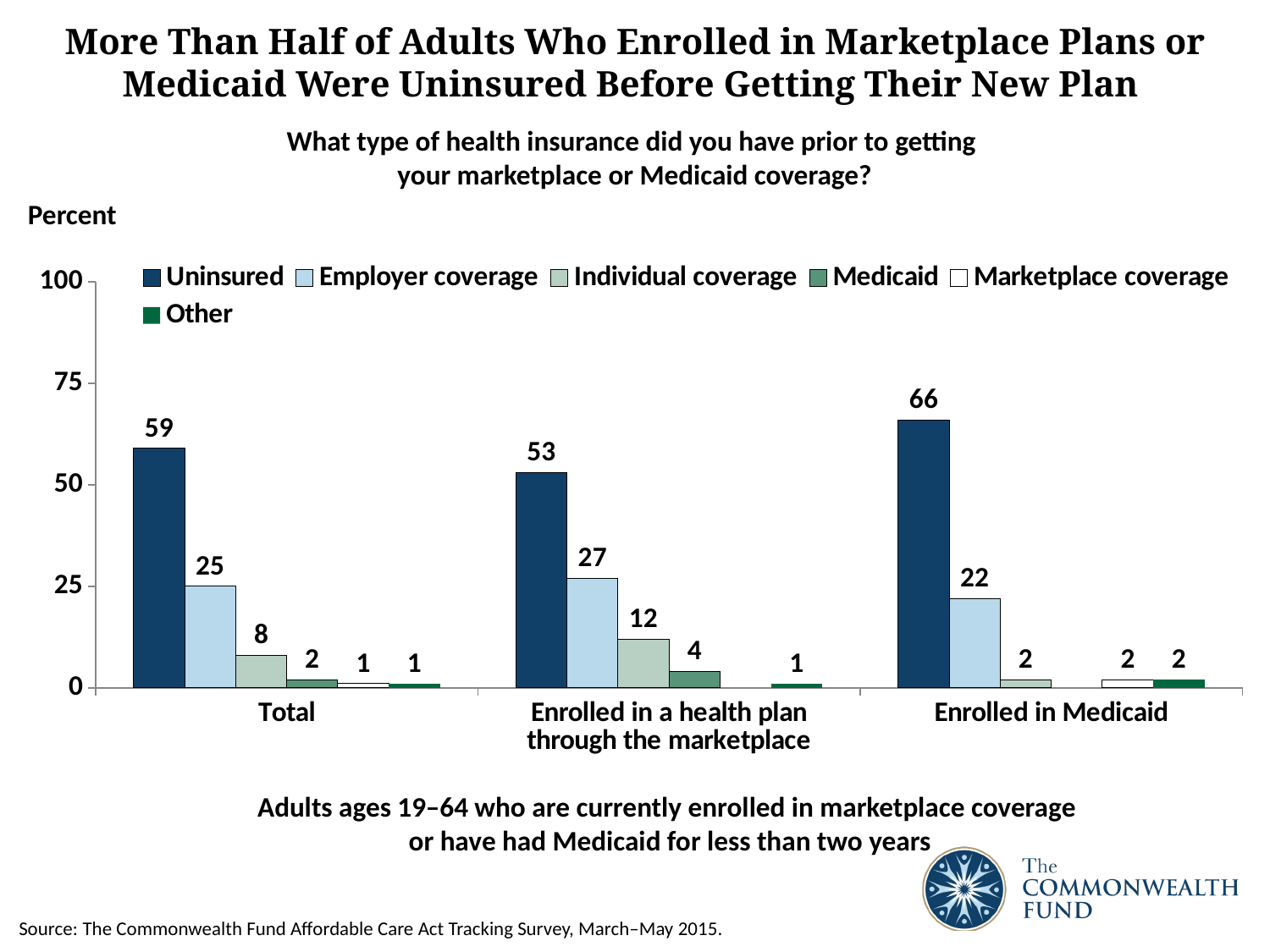
What is the difference between the Uninsured values for Enrolled in Medicaid and Enrolled in a health plan through the marketplace? 13 What is the value for Individual coverage in the Total group? 8 What kind of chart is shown on the slide? Bar chart How many series does the legend list? 6 Which group has the lowest Employer coverage value? Enrolled in Medicaid What is the value for Employer coverage among adults enrolled in a health plan through the marketplace? 27 Which is larger: Individual coverage for Enrolled in a health plan through the marketplace or Individual coverage for Enrolled in Medicaid? Enrolled in a health plan through the marketplace Which group has the highest Uninsured value? Enrolled in Medicaid What is the value for Uninsured among adults enrolled in Medicaid? 66 What percentage of adults in the Total group were uninsured before getting their new plan? 59 How many groups are shown on the x axis? 3 Is the Uninsured value for the Total group greater or less than 50? greater